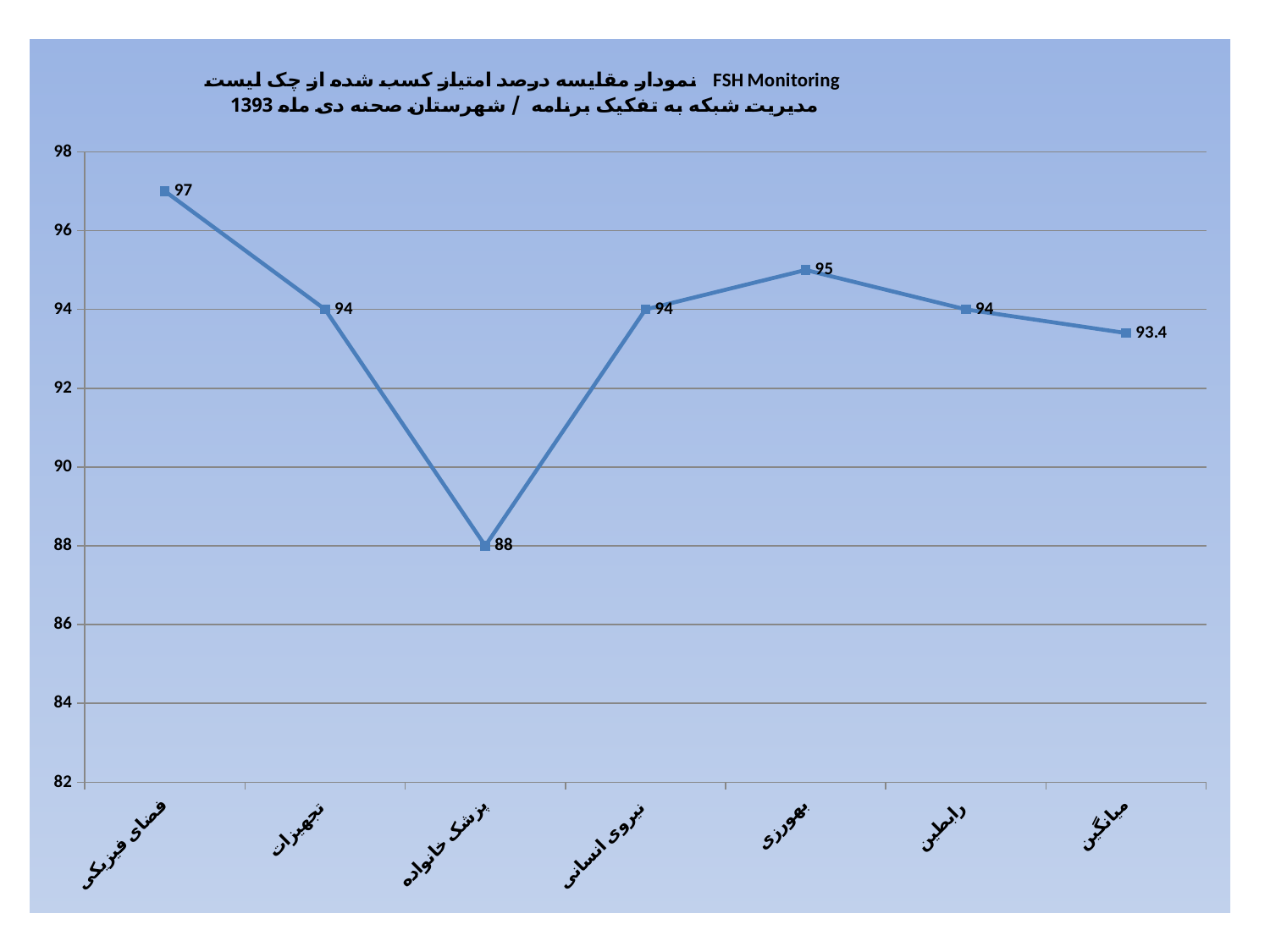
Is the value for پزشک خانواده greater or less than 90? less Which category has the highest value? فضای فیزیکی What is the value for بهورزی? 95 What is the value for تجهیزات? 94 Which category has the lowest value? پزشک خانواده Which is larger, the value for بهورزی or the value for رابطین? بهورزی What is the value for میانگین? 93.4 What is the difference between the values for فضای فیزیکی and پزشک خانواده? 9 What is the value for پزشک خانواده? 88 What is the value for فضای فیزیکی? 97 What type of chart is shown on the slide? line chart How many categories are plotted on the x axis? 7